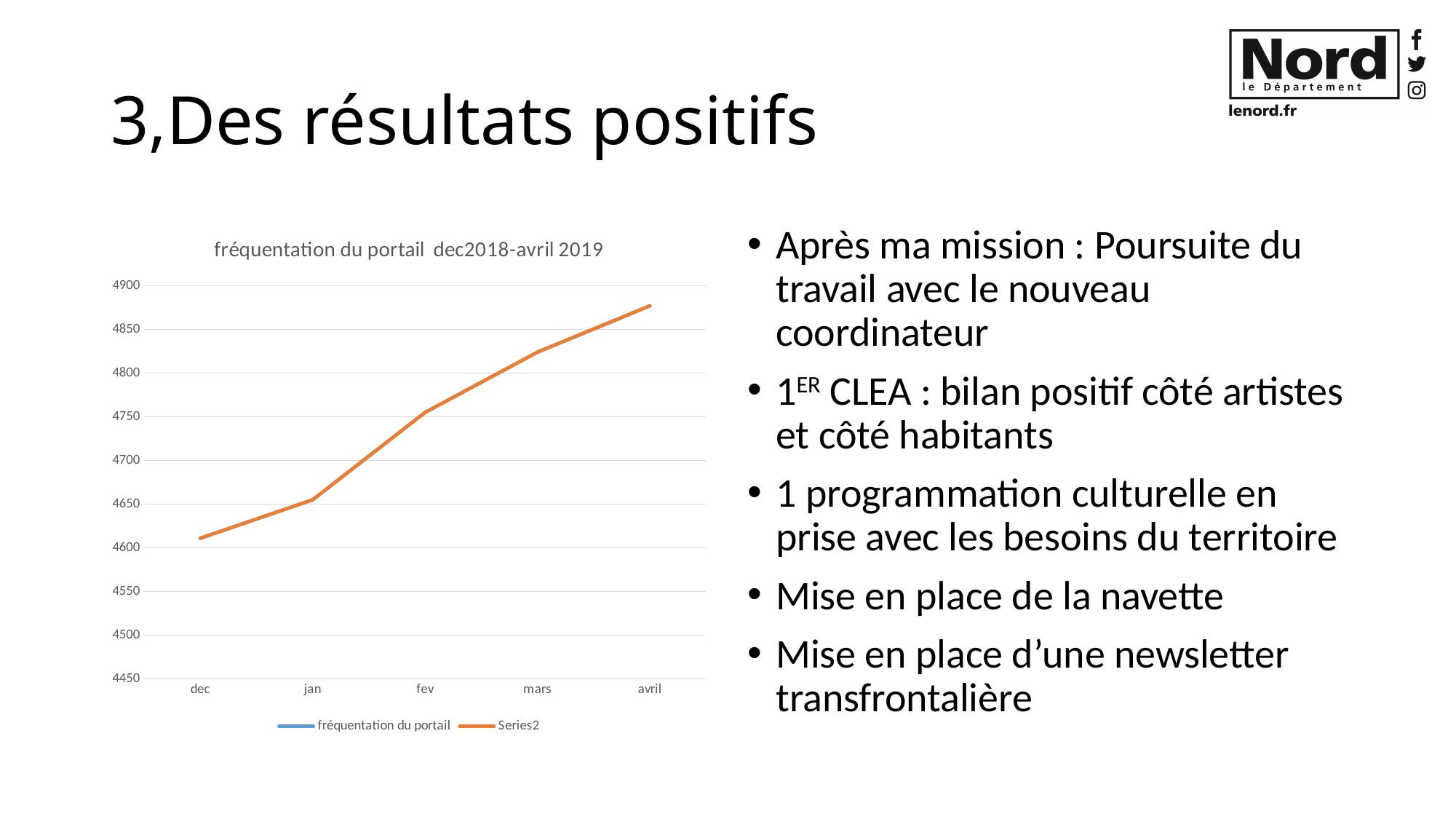
How many months are plotted along the x axis of the chart? 5 What type of chart is shown on the slide? line chart Which month has the lowest value on the chart? dec Is the value for dec greater or less than 4650? less Do the values rise or fall from dec to avril? rise How many series does the chart legend list? 2 Which is larger, the value for jan or the value for mars? mars What is the title of the chart? fréquentation du portail dec2018-avril 2019 Is the value for avril greater or less than 4900? less Is the value for fev greater or less than 4700? greater Which month has the highest value on the chart? avril